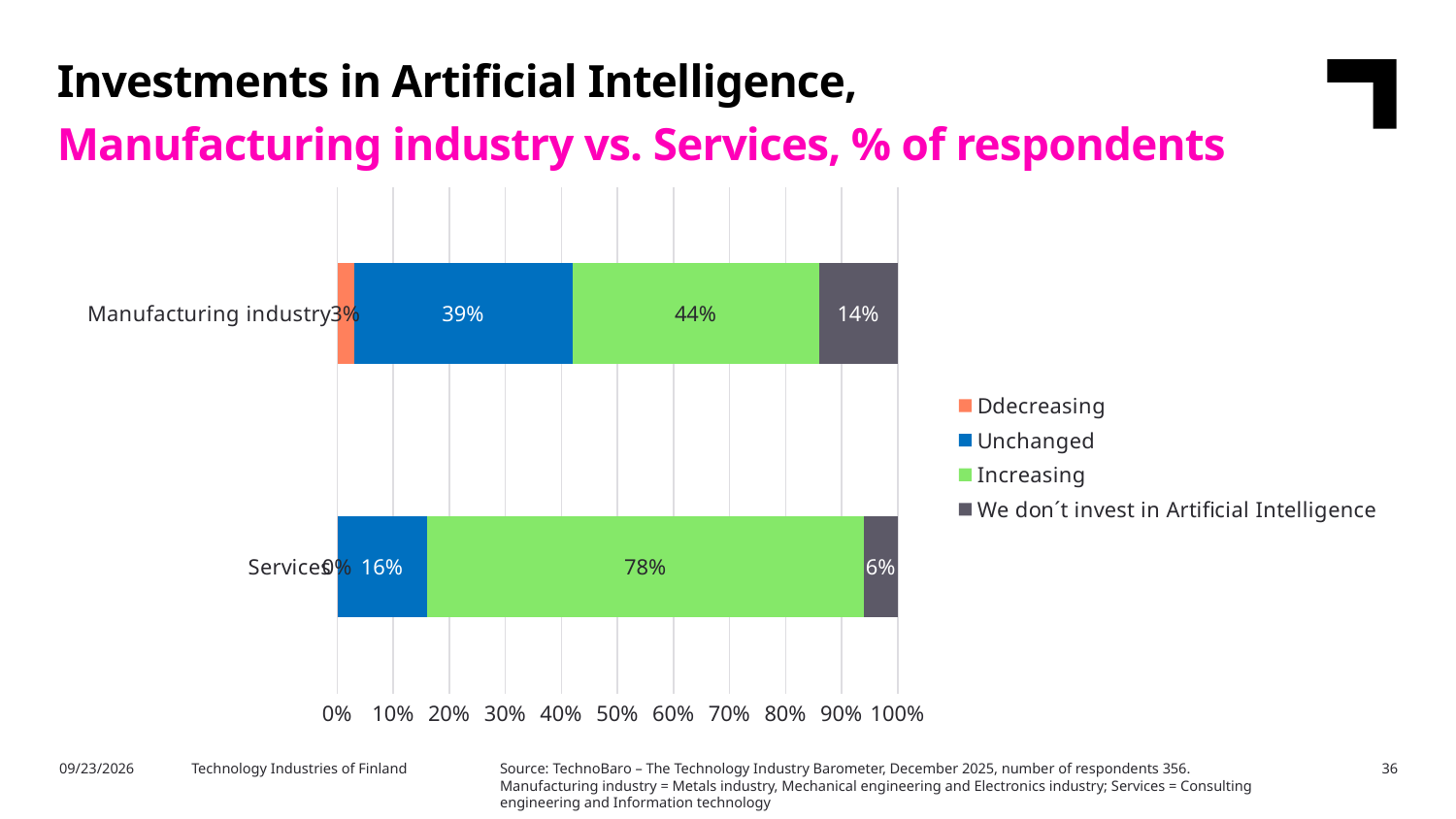
What kind of chart is shown on the slide? Stacked bar chart What percentage of Services respondents report Increasing investments in Artificial Intelligence? 78% What percentage of Services respondents report Ddecreasing investments? 0% How many series does the legend list? 4 What percentage of Manufacturing industry respondents report Increasing investments in Artificial Intelligence? 44% What percentage of Manufacturing industry respondents report Unchanged investments? 39% What percentage of Services respondents say they don't invest in Artificial Intelligence? 6% Which colour represents the Increasing series in the chart? Green What is the difference between the Increasing share for Services and the Increasing share for Manufacturing industry? 34 percentage points Which category has the higher share of respondents reporting Increasing investments, Manufacturing industry or Services? Services What is the difference between the Unchanged share for Manufacturing industry and the Unchanged share for Services? 23 percentage points How many categories are shown on the chart? 2